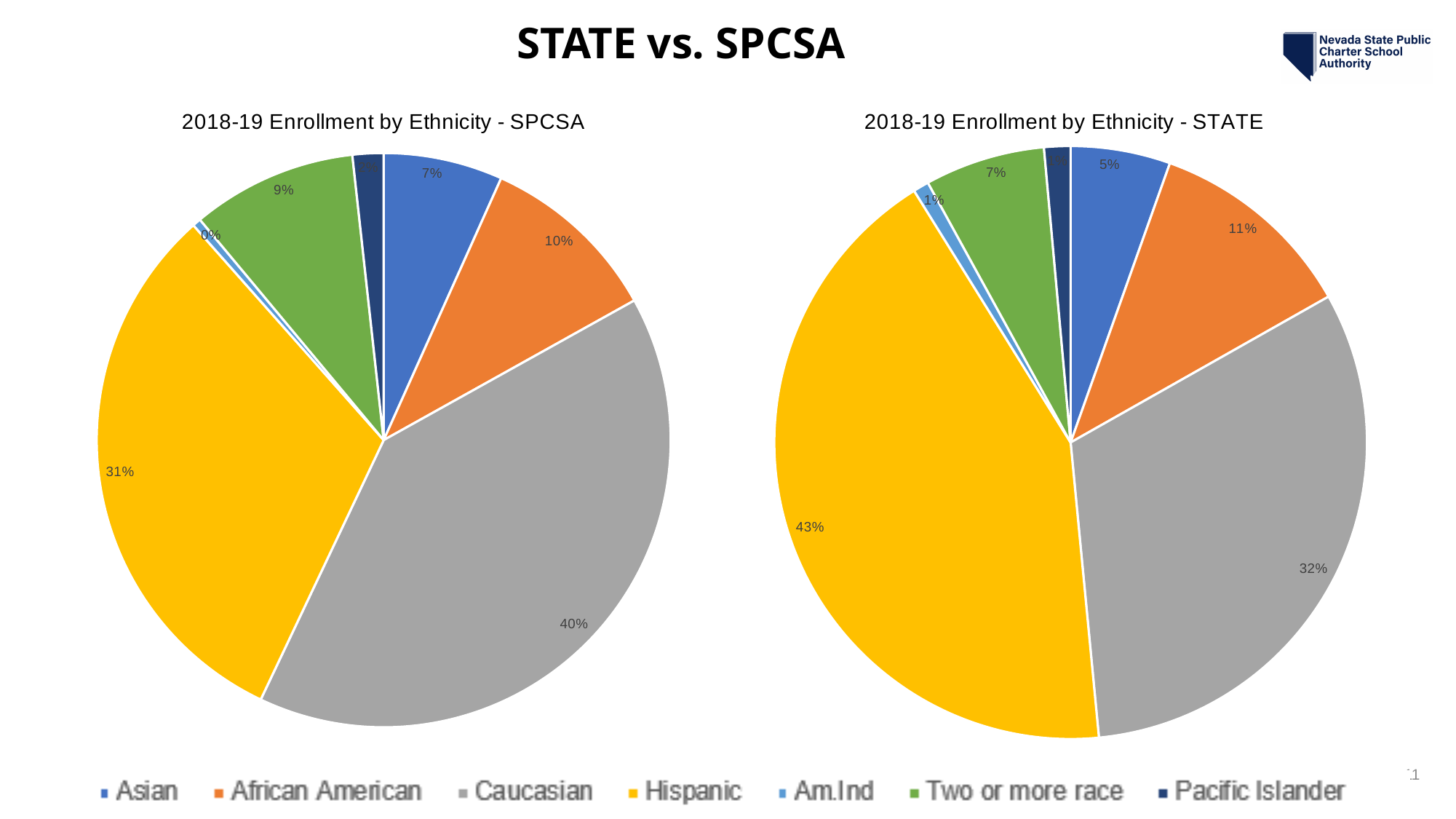
In the 2018-19 Enrollment by Ethnicity - STATE chart, which ethnicity has the largest share? Hispanic In the 2018-19 Enrollment by Ethnicity - SPCSA chart, which ethnicity has the largest share? Caucasian What type of chart is the 2018-19 Enrollment by Ethnicity - STATE chart? Pie chart In the 2018-19 Enrollment by Ethnicity - SPCSA chart, what share is Hispanic? 31% Which chart shows a larger Hispanic share, the SPCSA chart or the STATE chart? STATE How many entries does the shared legend list? 7 In the 2018-19 Enrollment by Ethnicity - STATE chart, what share is Hispanic? 43% In the 2018-19 Enrollment by Ethnicity - STATE chart, what is the difference between the Hispanic and Caucasian shares? 11% In the 2018-19 Enrollment by Ethnicity - SPCSA chart, what share is Caucasian? 40% In the 2018-19 Enrollment by Ethnicity - STATE chart, what share is African American? 11% In the 2018-19 Enrollment by Ethnicity - SPCSA chart, which ethnicity has the smallest share? Am.Ind In the 2018-19 Enrollment by Ethnicity - SPCSA chart, which is larger, the Asian share or the African American share? African American